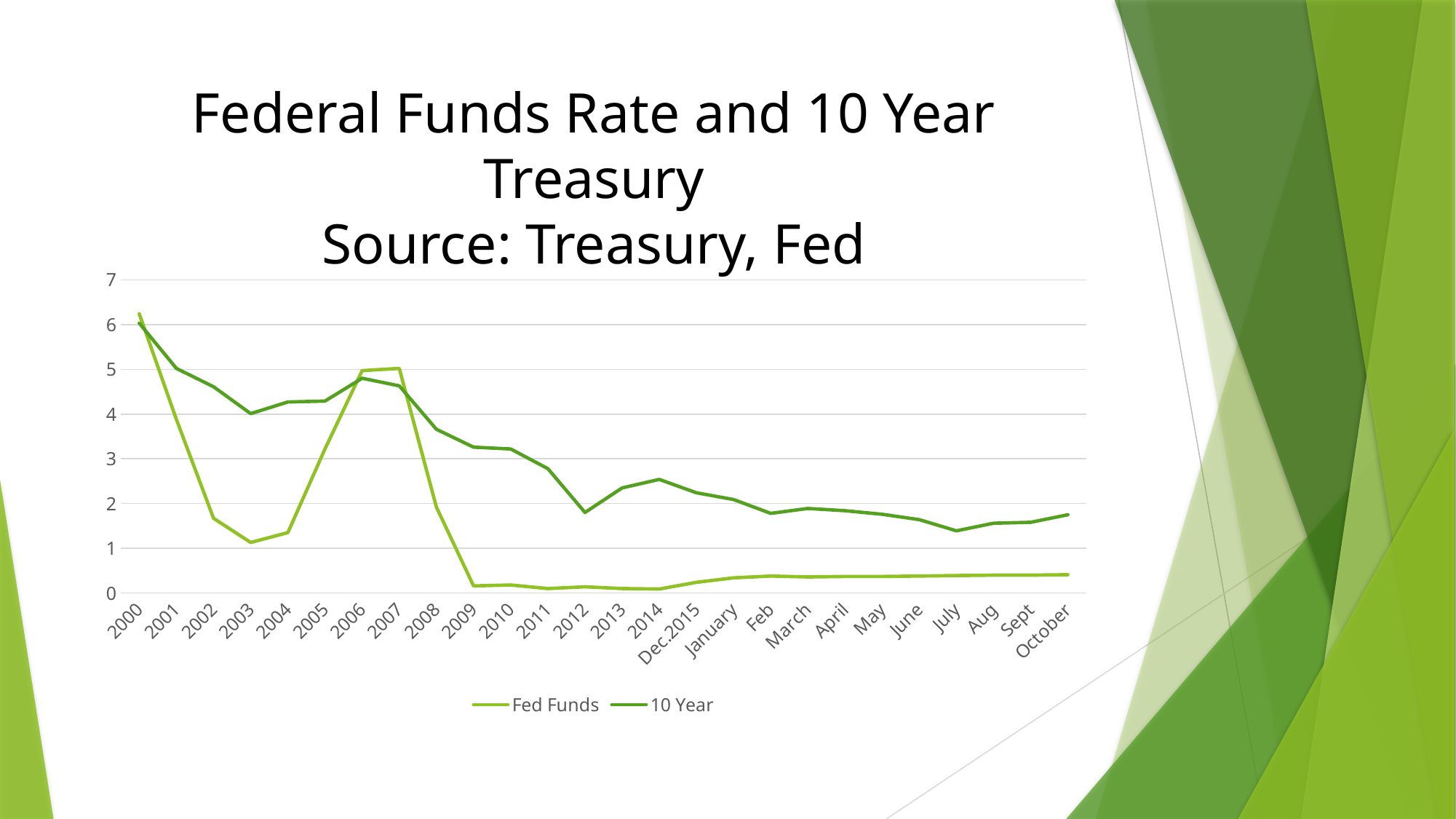
How many series does the legend list? 2 In which category does the 10 Year series reach its lowest value? July Does the Fed Funds series rise or fall from 2000 to 2003? Fall Is the 10 Year value for 2009 greater or less than 3? greater What kind of chart is shown on the slide? Line chart In 2002, which series has the larger value, Fed Funds or 10 Year? 10 Year Does the Fed Funds series rise or fall from 2004 to 2006? Rise Is the Fed Funds value for 2009 greater or less than 1? less What are the names of the two series in the legend? Fed Funds and 10 Year In which category does the Fed Funds series reach its highest value? 2000 How many categories are shown along the x axis? 26 Is the Fed Funds value for 2003 greater or less than 2? less